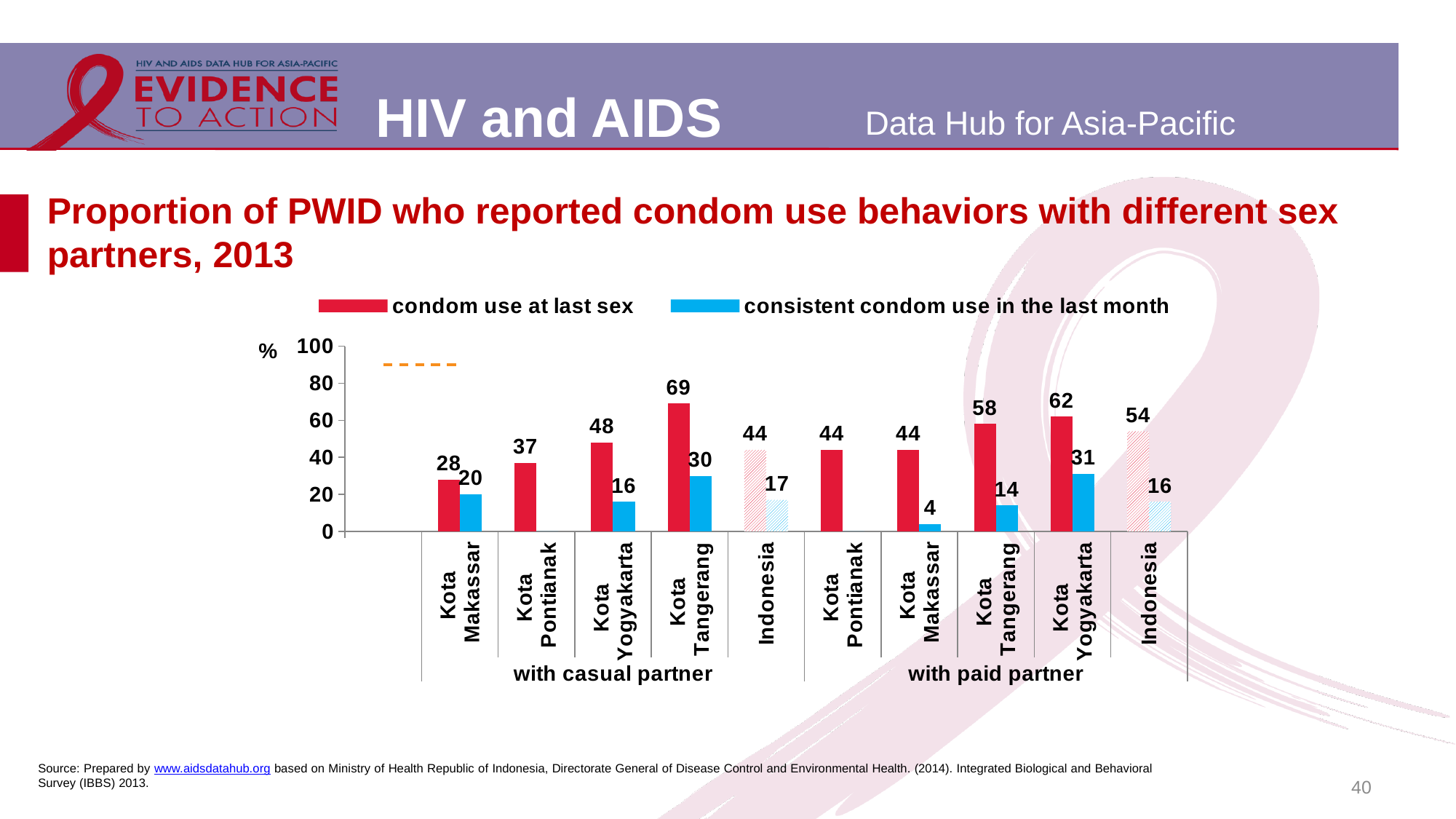
How many categories are shown on the x axis? 10 Is the value for condom use at last sex for Kota Tangerang with paid partner greater or less than 40? greater What is the value for condom use at last sex for Indonesia with paid partner? 54 What kind of chart is shown on the slide? bar chart How many series does the legend list? 2 What colour represents consistent condom use in the last month in the legend? blue Which is larger: condom use at last sex for Kota Yogyakarta with casual partner or for Kota Yogyakarta with paid partner? Kota Yogyakarta with paid partner Which category has the highest value for condom use at last sex? Kota Tangerang (with casual partner) Which category has the lowest value for consistent condom use in the last month among those with a blue bar? Kota Makassar (with paid partner) What is the value for condom use at last sex for Kota Tangerang with casual partner? 69 What is the difference between condom use at last sex and consistent condom use in the last month for Kota Yogyakarta with paid partner? 31 What is the value for consistent condom use in the last month for Kota Makassar with paid partner? 4